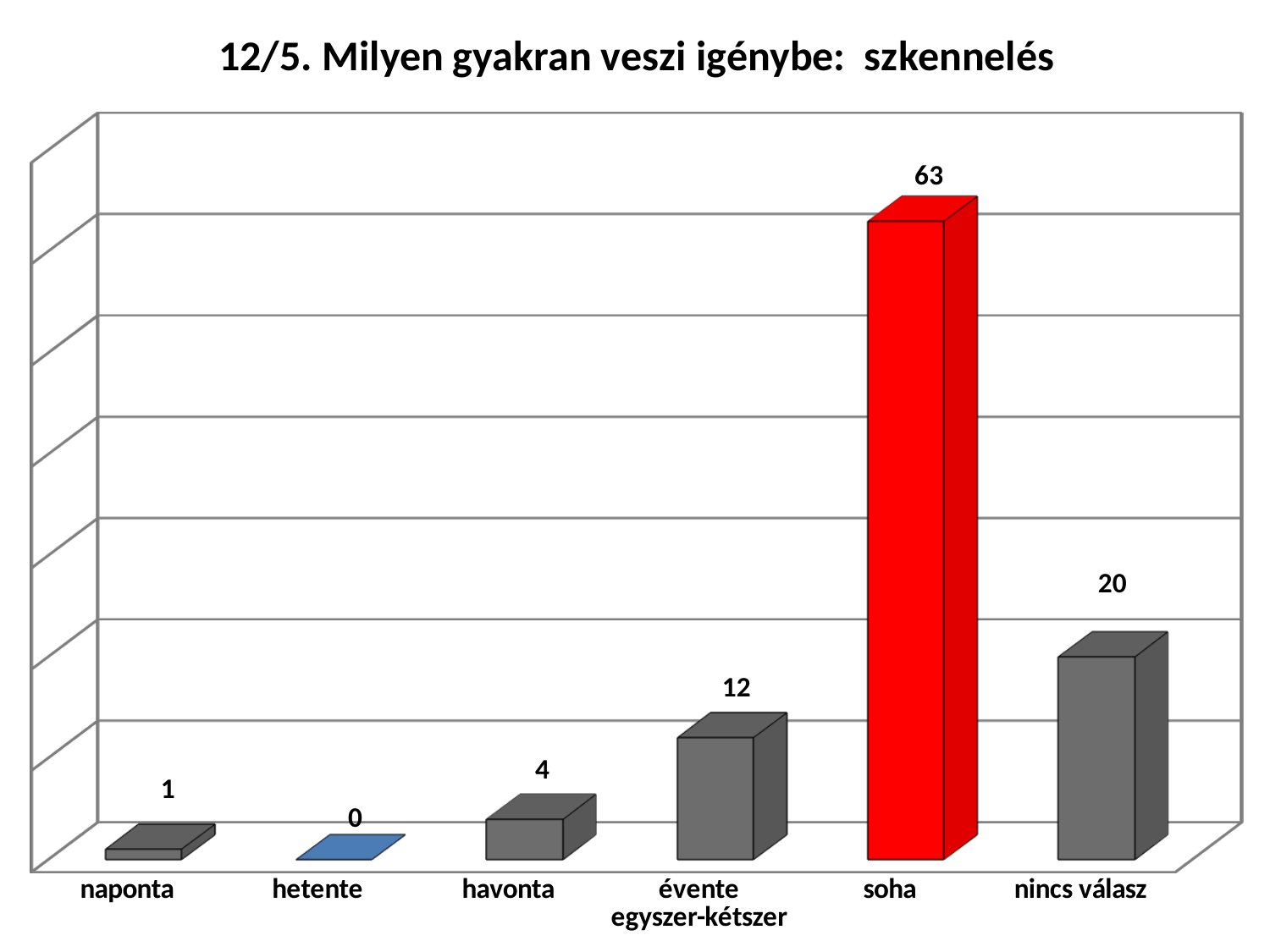
Which is larger, the value for "naponta" or the value for "havonta"? havonta What is the value for "nincs válasz"? 20 What kind of chart is shown on the slide? bar chart Which category has the lowest value? hetente What is the value for "évente egyszer-kétszer"? 12 What is the value for "soha"? 63 How many categories are shown on the x axis? 6 Which category has the highest value? soha What is the value for "hetente"? 0 What is the title of the chart? 12/5. Milyen gyakran veszi igénybe: szkennelés What is the difference between the values for "évente egyszer-kétszer" and "havonta"? 8 What is the difference between the values for "soha" and "nincs válasz"? 43